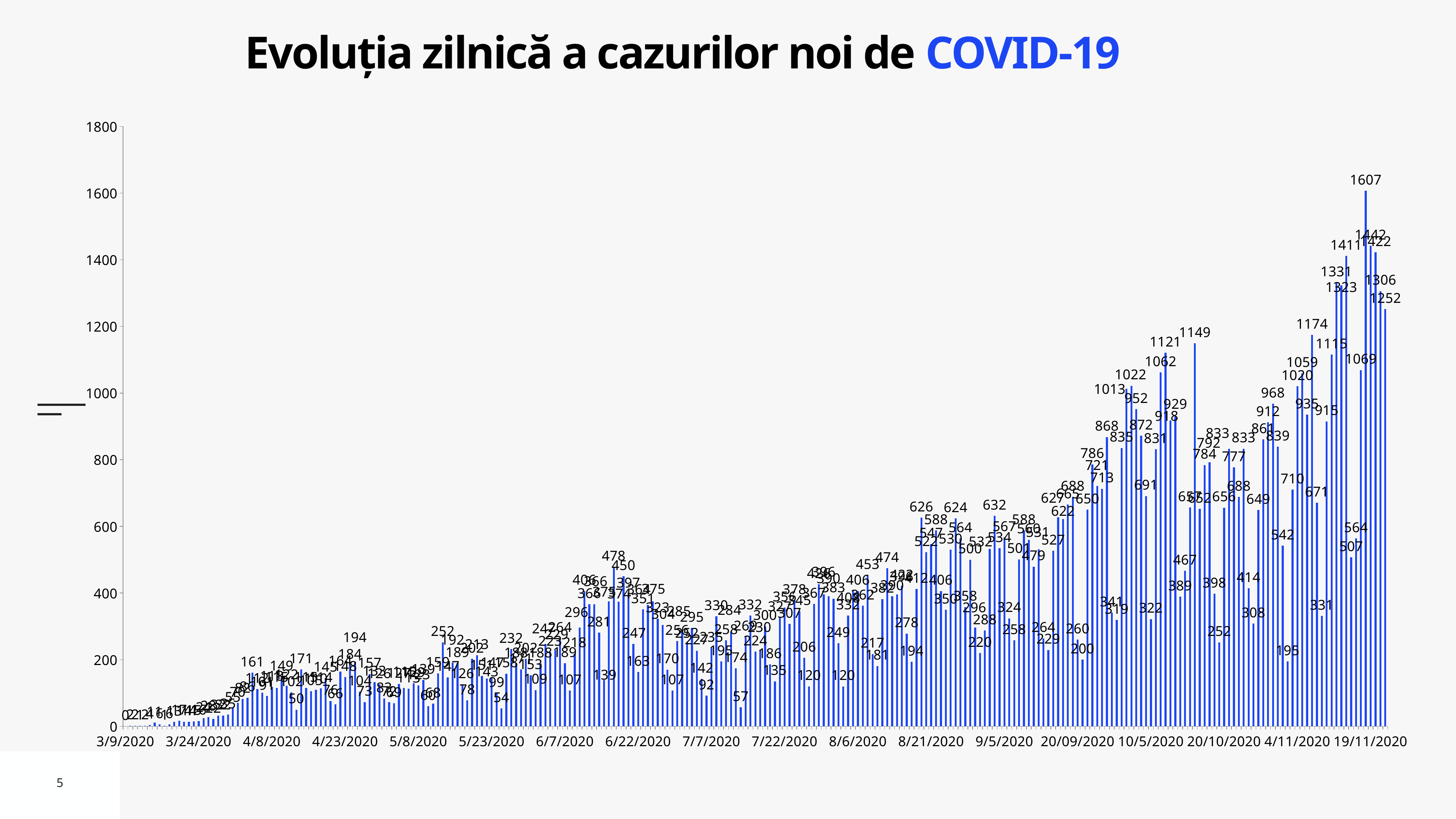
What is the value labeled on the first bar, at 3/9/2020? 0 What is the highest daily value labeled on the chart? 1607 Is the highest bar on the chart greater or less than 1400? greater Which is larger, the bar labeled 1607 or the bar labeled 1252? 1607 What is the difference between the highest labeled value (1607) and the last labeled value (1252)? 355 What is the highest tick value shown on the y axis? 1800 What is the title of the chart? Evoluția zilnică a cazurilor noi de COVID-19 Is the value for the first bar (3/9/2020) greater or less than 200? less Overall, do the daily values rise or fall from left to right along the x axis? rise What kind of chart is shown on the slide? bar chart What is the last date label shown on the x axis? 19/11/2020